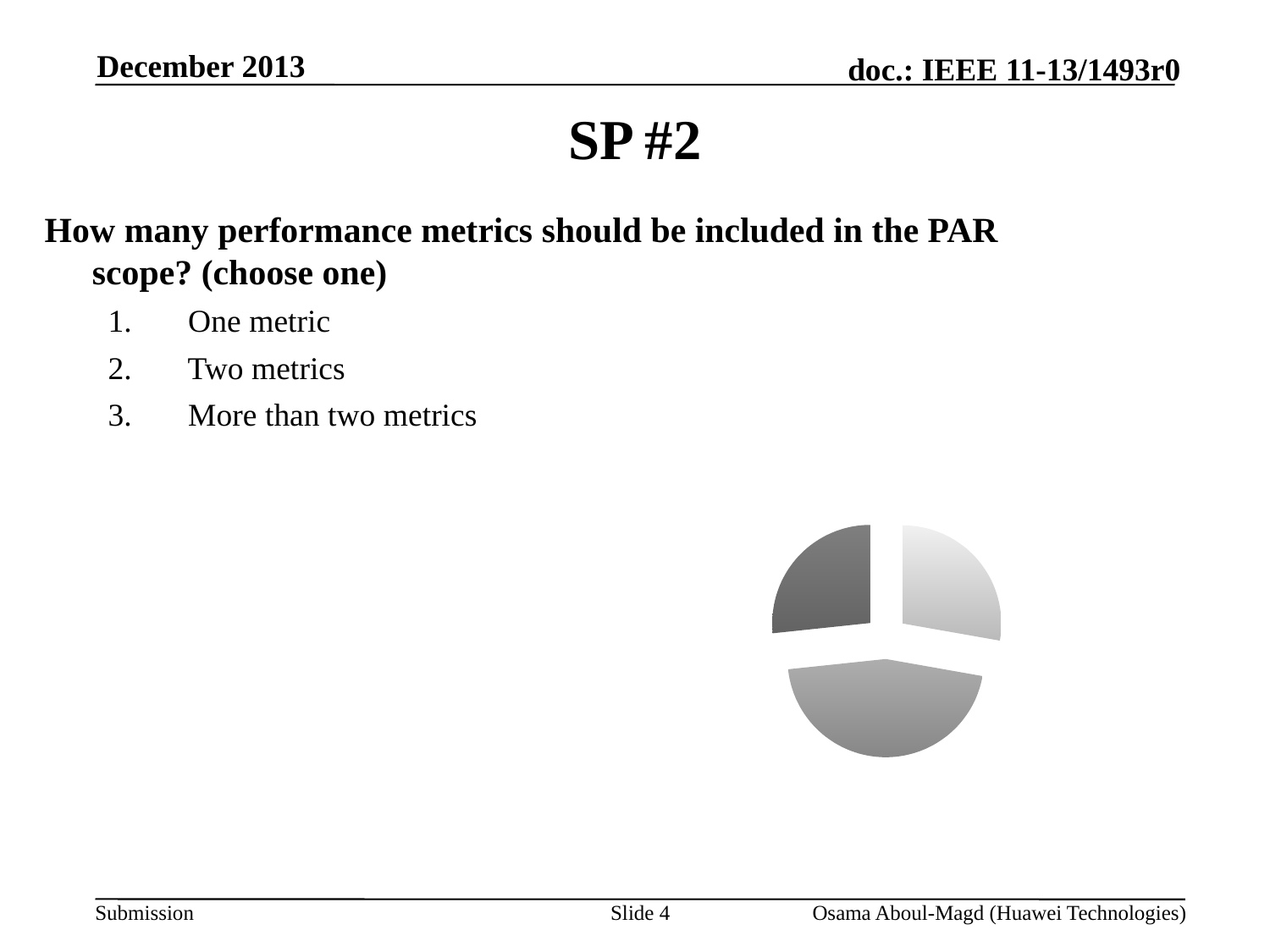
What kind of chart is shown on the slide? pie chart Does the pie chart show a legend? No Is the bottom slice of the pie chart larger or smaller than the dark grey top-left slice? larger Does the pie chart display data labels on its slices? No Which slice of the pie chart is the largest: the dark grey slice at the top left, the light grey slice at the top right, or the medium grey slice at the bottom? the medium grey slice at the bottom How many slices does the pie chart have? 3 Is the bottom slice of the pie chart larger or smaller than the light grey top-right slice? larger